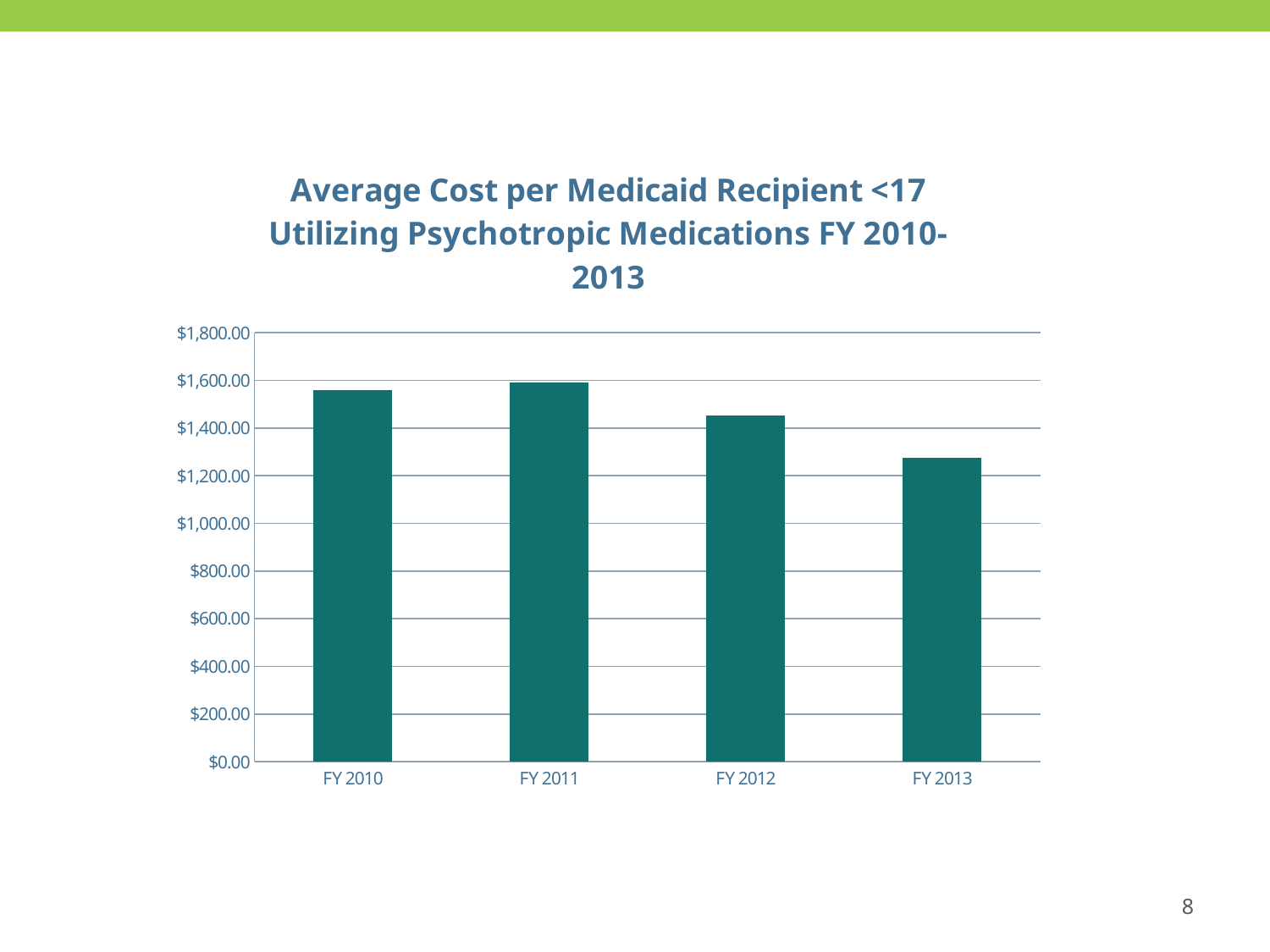
What is the title of the chart? Average Cost per Medicaid Recipient <17 Utilizing Psychotropic Medications FY 2010-2013 Which fiscal year has the lowest average cost per Medicaid recipient? FY 2013 Is the average cost for FY 2010 greater or less than $1,400.00? greater Which is larger, the average cost for FY 2010 or for FY 2012? FY 2010 Is the average cost for FY 2013 greater or less than $1,400.00? less From FY 2011 to FY 2013, do the average costs rise or fall? fall Is the average cost for FY 2013 greater or less than $1,200.00? greater How many fiscal years are shown on the x axis of the chart? 4 What kind of chart is shown on the slide? bar chart Which is larger, the average cost for FY 2012 or for FY 2013? FY 2012